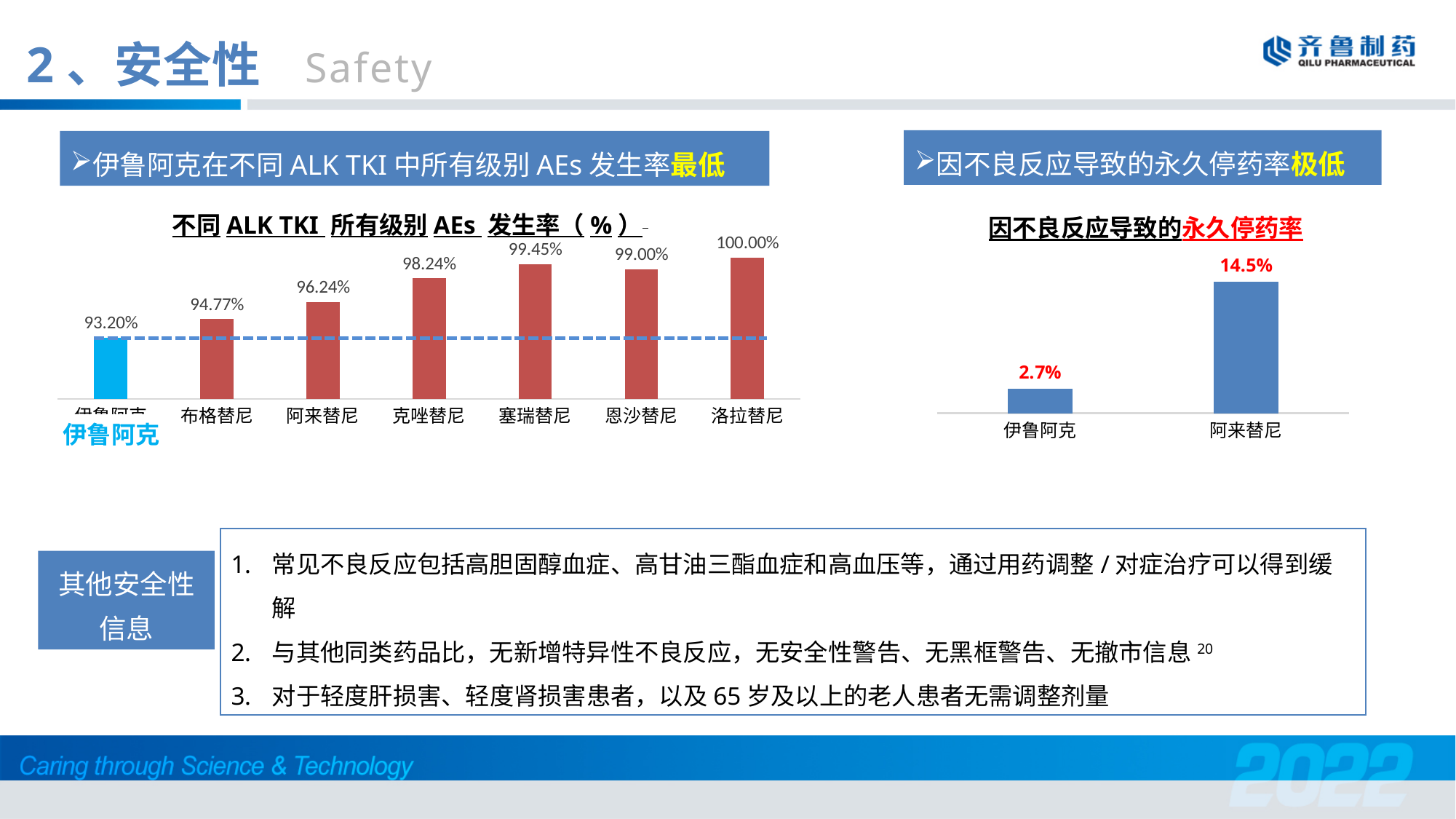
In the left chart, what colour is the bar for 伊鲁阿克? Blue How many drugs (bars) are shown in the left chart (不同 ALK TKI 所有级别 AEs 发生率)? 7 In the left chart (不同 ALK TKI 所有级别 AEs 发生率), what is the value for 克唑替尼? 98.24% In the left chart (不同 ALK TKI 所有级别 AEs 发生率), what is the value for 伊鲁阿克? 93.20% In the left chart (不同 ALK TKI 所有级别 AEs 发生率), which drug has the highest AE rate? 洛拉替尼 In the left chart (不同 ALK TKI 所有级别 AEs 发生率), what is the value for 恩沙替尼? 99.00% In the right chart (因不良反应导致的永久停药率), what is the difference between the values for 阿来替尼 and 伊鲁阿克? 11.8% In the right chart (因不良反应导致的永久停药率), what is the value for 阿来替尼? 14.5% In the left chart (不同 ALK TKI 所有级别 AEs 发生率), what is the difference between the values for 洛拉替尼 and 伊鲁阿克? 6.80% In the left chart (不同 ALK TKI 所有级别 AEs 发生率), which drug has the lowest AE rate? 伊鲁阿克 In the left chart (不同 ALK TKI 所有级别 AEs 发生率), which is larger, the value for 布格替尼 or 阿来替尼? 阿来替尼 What kind of chart is the right chart (因不良反应导致的永久停药率)? Bar chart